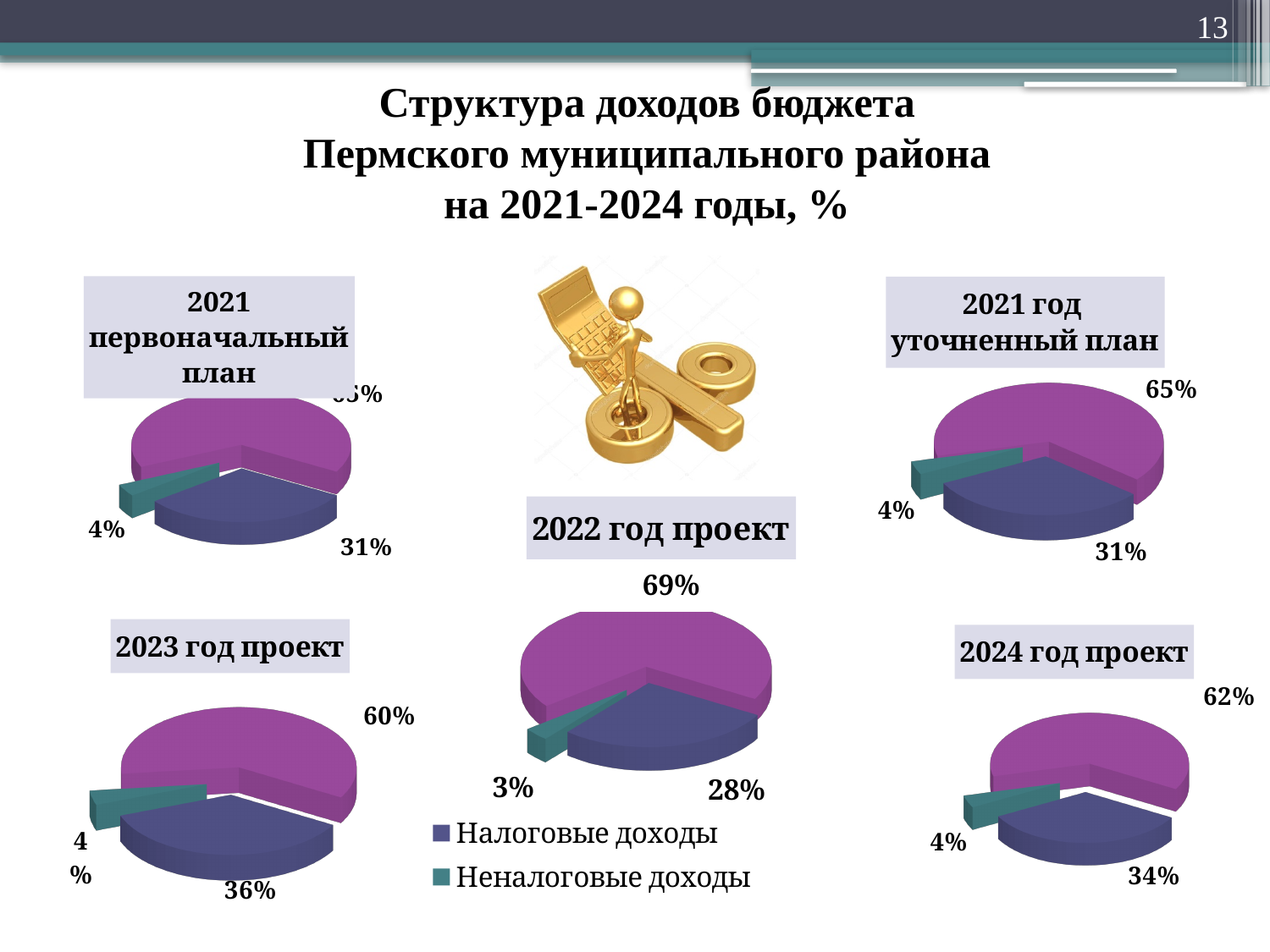
What is the difference between the Налоговые доходы share in the '2023 год проект' chart and in the '2024 год проект' chart? 2% Which chart shows a larger share for Налоговые доходы: '2022 год проект' or '2023 год проект'? 2023 год проект In the '2022 год проект' chart, what share is shown for Налоговые доходы? 28% What type of chart is used on this slide? Pie chart In the '2024 год проект' chart, what share is shown for Налоговые доходы? 34% In the '2021 год уточненный план' chart, what share is shown for Неналоговые доходы? 4% In the '2022 год проект' chart, what share is shown for Неналоговые доходы? 3% In the '2023 год проект' chart, what share is shown for Налоговые доходы? 36% In the '2022 год проект' chart, what is the value of the largest slice? 69% In the '2023 год проект' chart, what is the value of the smallest slice? 4% In the '2021 год уточненный план' chart, what is the largest slice's value? 65% How many series does the legend list? 2